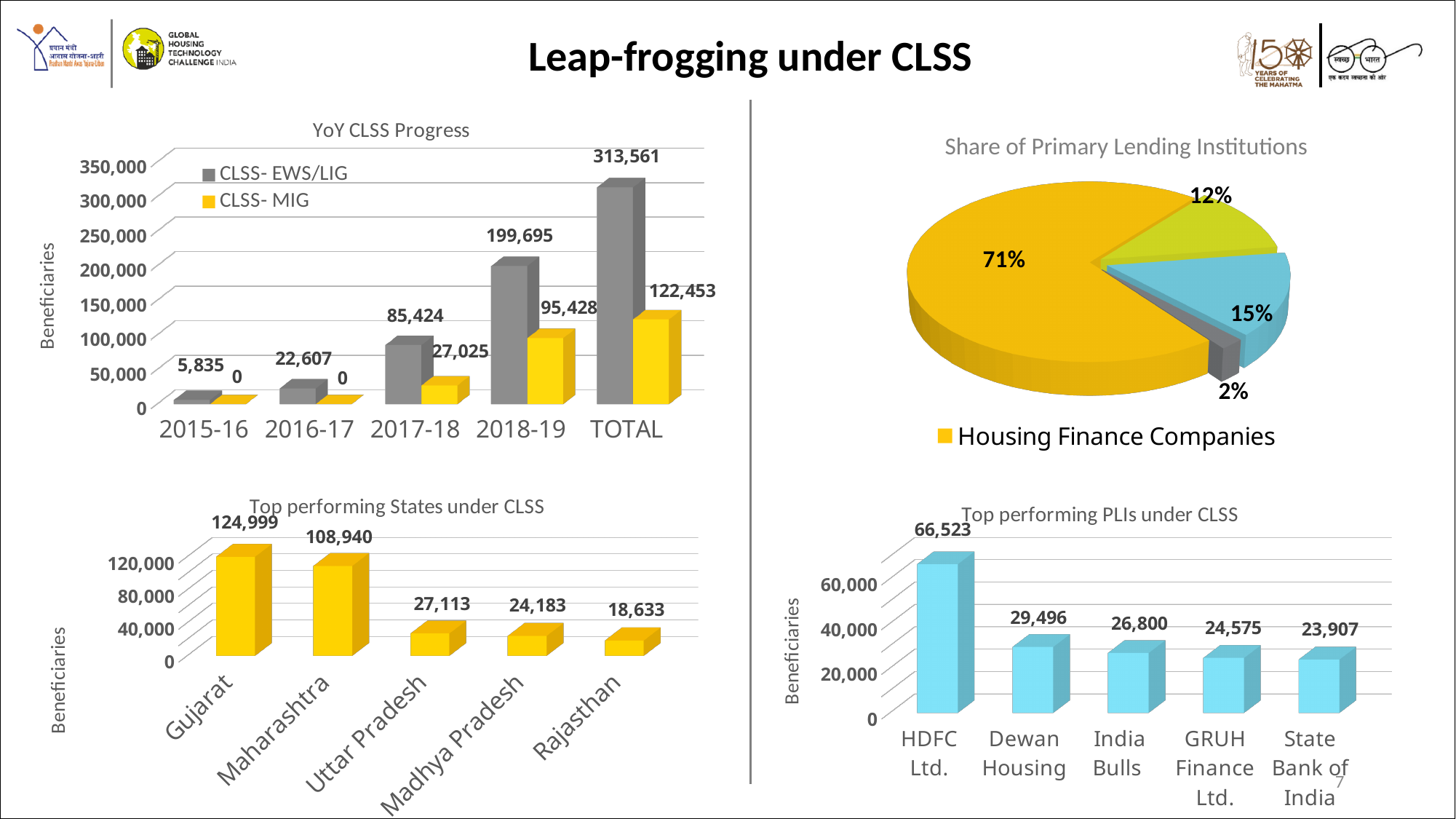
In the 'YoY CLSS Progress' chart, what is the difference between the CLSS- EWS/LIG and CLSS- MIG values for 2017-18? 58,399 What kind of chart is 'Share of Primary Lending Institutions'? pie chart In the 'YoY CLSS Progress' chart, do the CLSS- EWS/LIG values rise or fall from 2015-16 to 2018-19? rise In the 'YoY CLSS Progress' chart, how many series does the legend list? 2 In the 'YoY CLSS Progress' chart, what is the CLSS- MIG value for TOTAL? 122,453 In the 'Top performing PLIs under CLSS' chart, which PLI has the lowest value? State Bank of India In the 'Share of Primary Lending Institutions' chart, what share does the largest slice have? 71% In the 'Top performing PLIs under CLSS' chart, what is the difference between HDFC Ltd. and Dewan Housing? 37,027 In the 'YoY CLSS Progress' chart, what is the CLSS- EWS/LIG value for 2018-19? 199,695 In the 'Top performing States under CLSS' chart, how many states are shown? 5 In the 'Top performing States under CLSS' chart, what is the value for Madhya Pradesh? 24,183 In the 'Top performing States under CLSS' chart, which state has the highest value? Gujarat